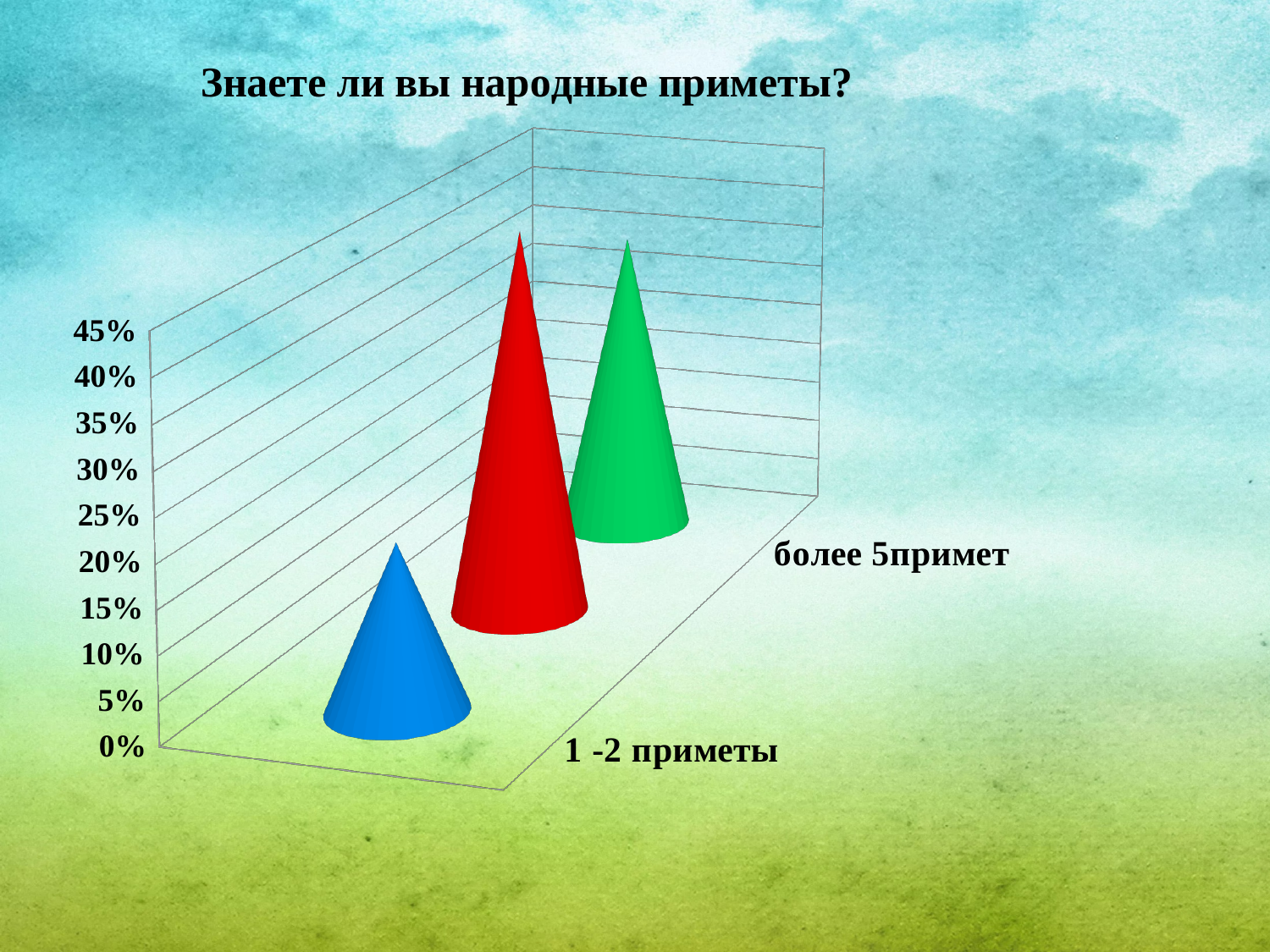
What kind of chart is shown on the slide? bar chart Which is larger, the green bar or the blue bar? the green bar What is the category label shown at the far end of the horizontal axis? более 5примет What is the title of the chart? Знаете ли вы народные приметы? How many bars (cones) are plotted in the chart? 3 Which is larger, the red bar or the blue bar? the red bar Is the value of the blue bar greater or less than 35%? less Is the value of the green bar greater or less than 20%? greater Which bar is the lowest in the chart? the blue one What is the highest value shown on the vertical axis? 45% Is the value of the red bar greater or less than 20%? greater